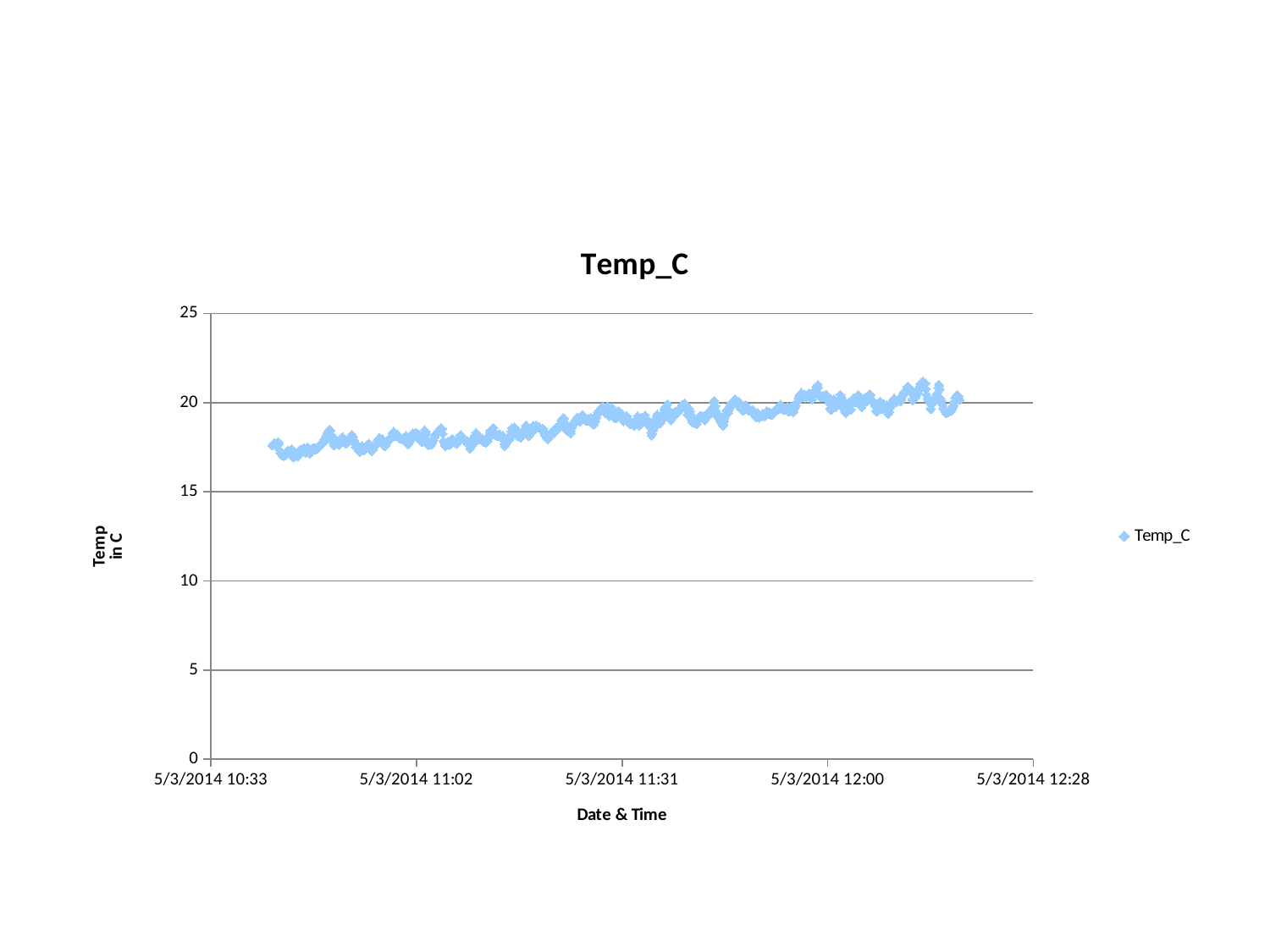
What is the title of the chart? Temp_C Are the Temp_C values near 5/3/2014 10:33 greater or less than 20? less What is the label of the y axis? Temp in C What is the highest value shown on the y axis? 25 Do the Temp_C values generally rise or fall from left to right along the x axis? rise Are the Temp_C values higher near 5/3/2014 12:00 or near 5/3/2014 10:33? 5/3/2014 12:00 Are the Temp_C values near 5/3/2014 11:31 greater or less than 25? less How many series does the legend list? 1 What kind of chart is shown on the slide? scatter chart Are the Temp_C values near 5/3/2014 12:00 greater or less than 15? greater